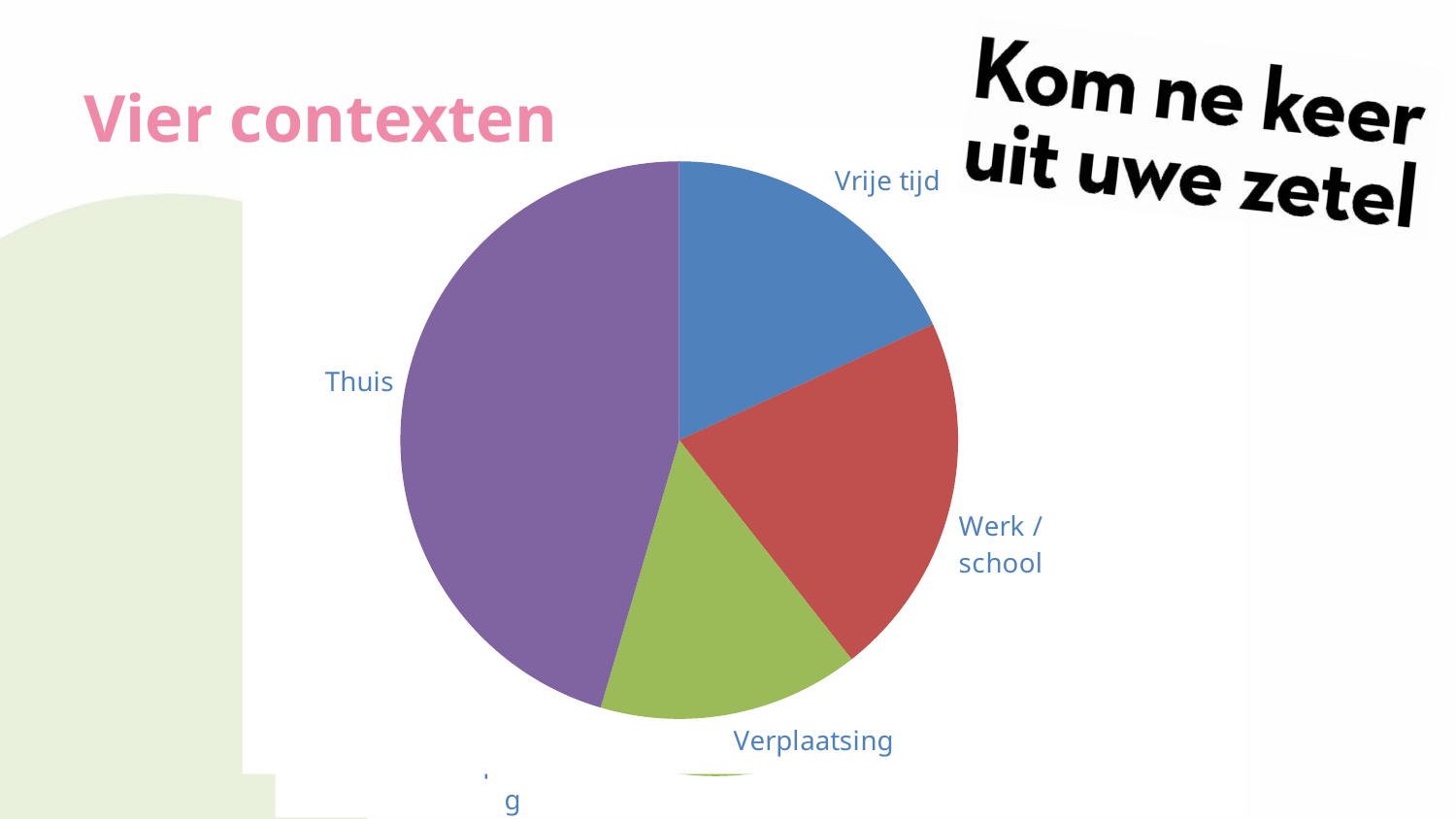
What kind of chart is shown on the slide? pie chart Which slice is larger, Thuis or Werk / school? Thuis What is the title shown above the pie chart on the slide? Vier contexten Which slice is larger, Thuis or Verplaatsing? Thuis How many slices does the pie chart have? 4 Which category has the largest slice of the pie chart? Thuis Which slice is larger, Thuis or Vrije tijd? Thuis What colour is the Thuis slice of the pie chart? purple